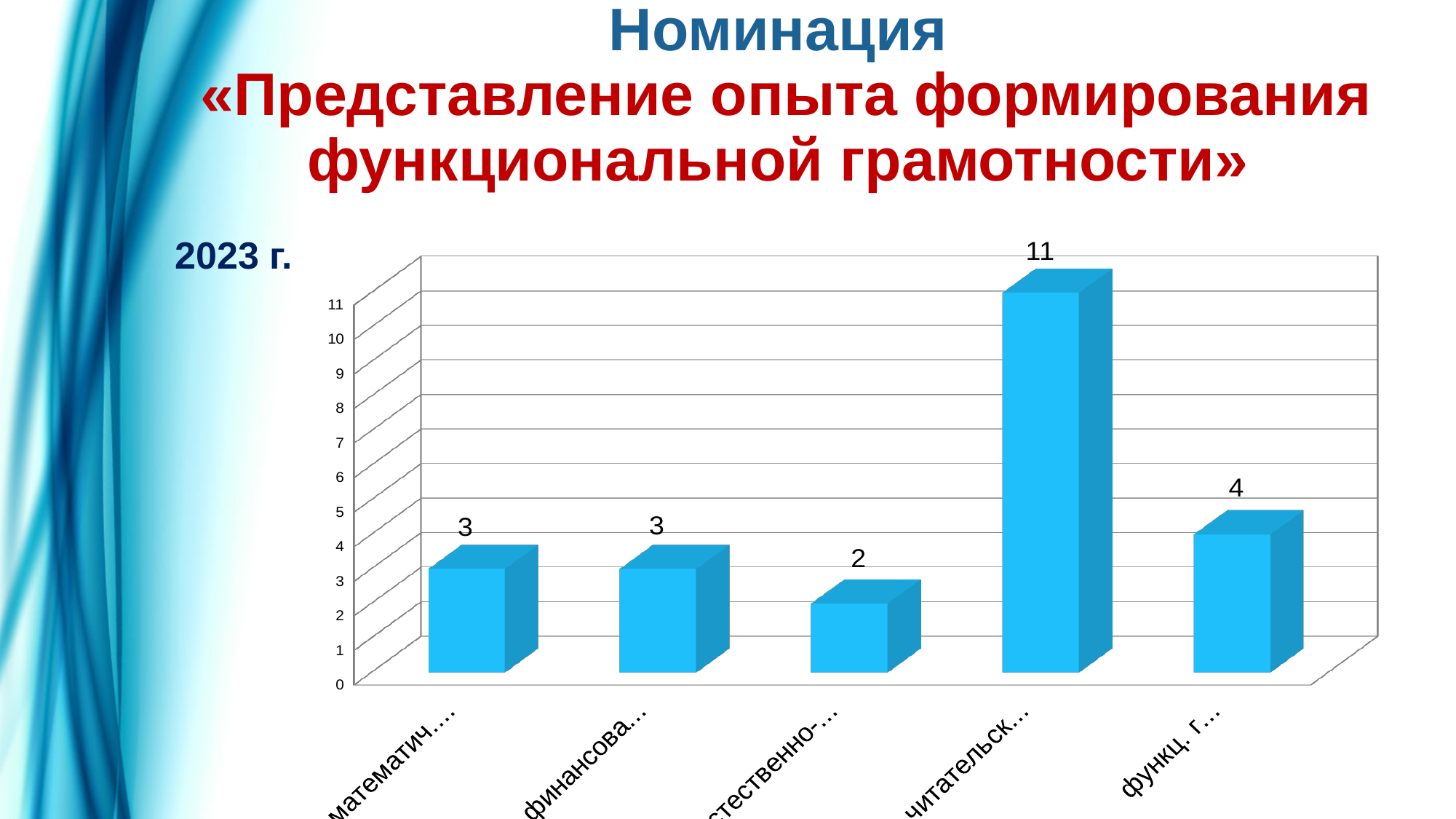
Which category has the lowest value? естественно-… (the third bar) What is the value of the fourth bar, labelled "читательск…"? 11 What year is indicated next to the chart? 2023 г. How many bars (categories) does the chart show? 5 What is the value of the first bar, labelled "математич…"? 3 What is the difference between the value of the "читательск…" bar and the "функц. г…" bar? 7 Which is larger: the value for "финансова…" or the value for "функц. г…"? функц. г… What is the value of the third bar, labelled "естественно-…"? 2 What type of chart is shown on the slide? bar chart Is the value of the "читательск…" bar greater or less than 10? greater What is the value of the last bar, labelled "функц. г…"? 4 Which category has the highest value? читательск… (the fourth bar)